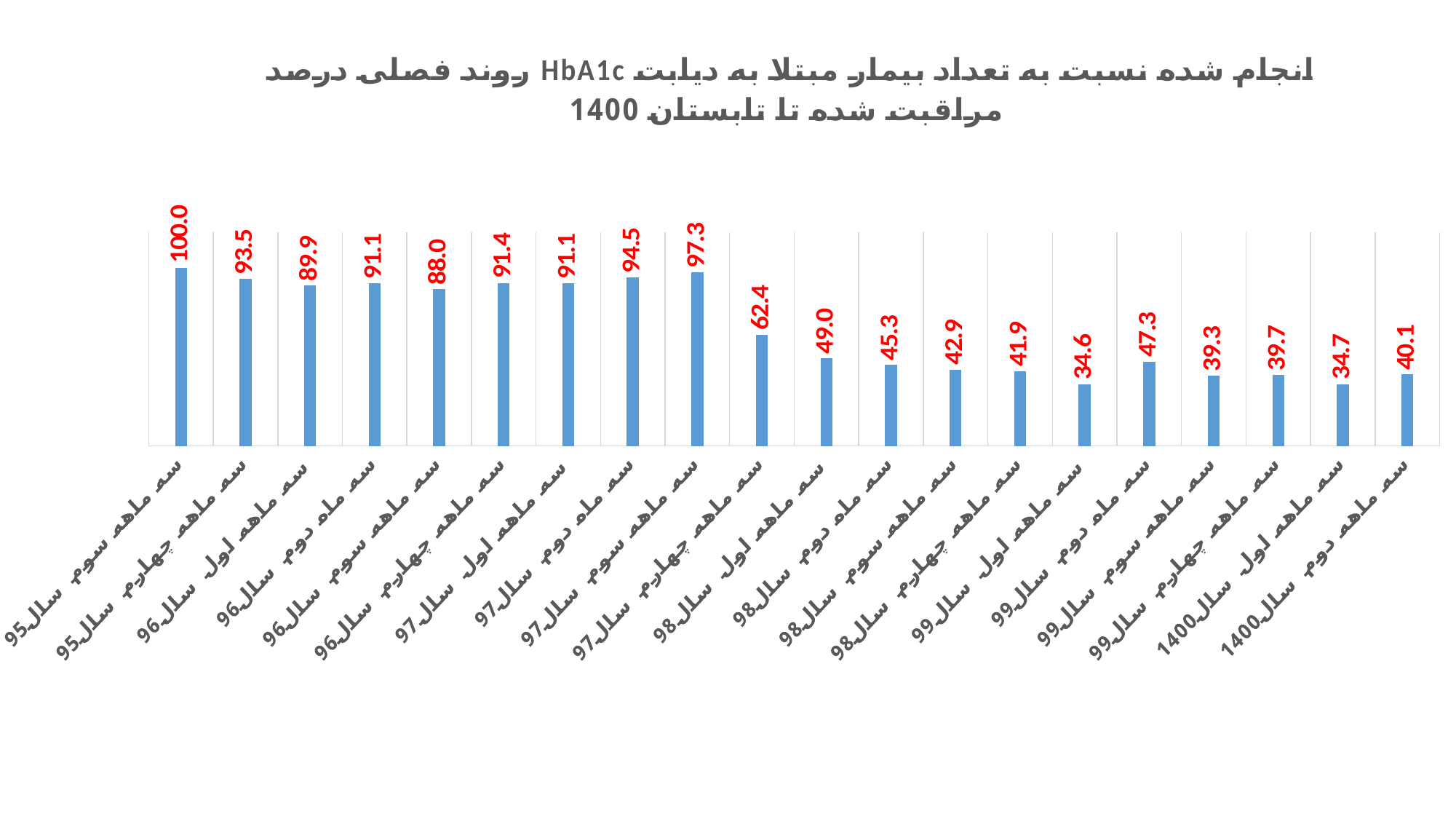
What colour are the bars in the chart? blue What is the value for سه ماهه دوم سال1400? 40.1 How many bars (quarters) are plotted in the chart? 20 What is the difference between the values for سه ماهه سوم سال97 and سه ماهه چهارم سال97? 34.9 Which quarter has the lowest value in the chart? سه ماهه اول سال99 What is the value for سه ماهه اول سال98? 49.0 Do the values generally rise or fall from left to right across the chart? fall Which is larger, the value for سه ماهه دوم سال99 or the value for سه ماهه سوم سال99? سه ماهه دوم سال99 What is the value for سه ماهه چهارم سال97? 62.4 Which quarter has the highest value in the chart? سه ماهه سوم سال95 What type of chart is shown on the slide? bar chart What is the value for سه ماهه سوم سال95? 100.0